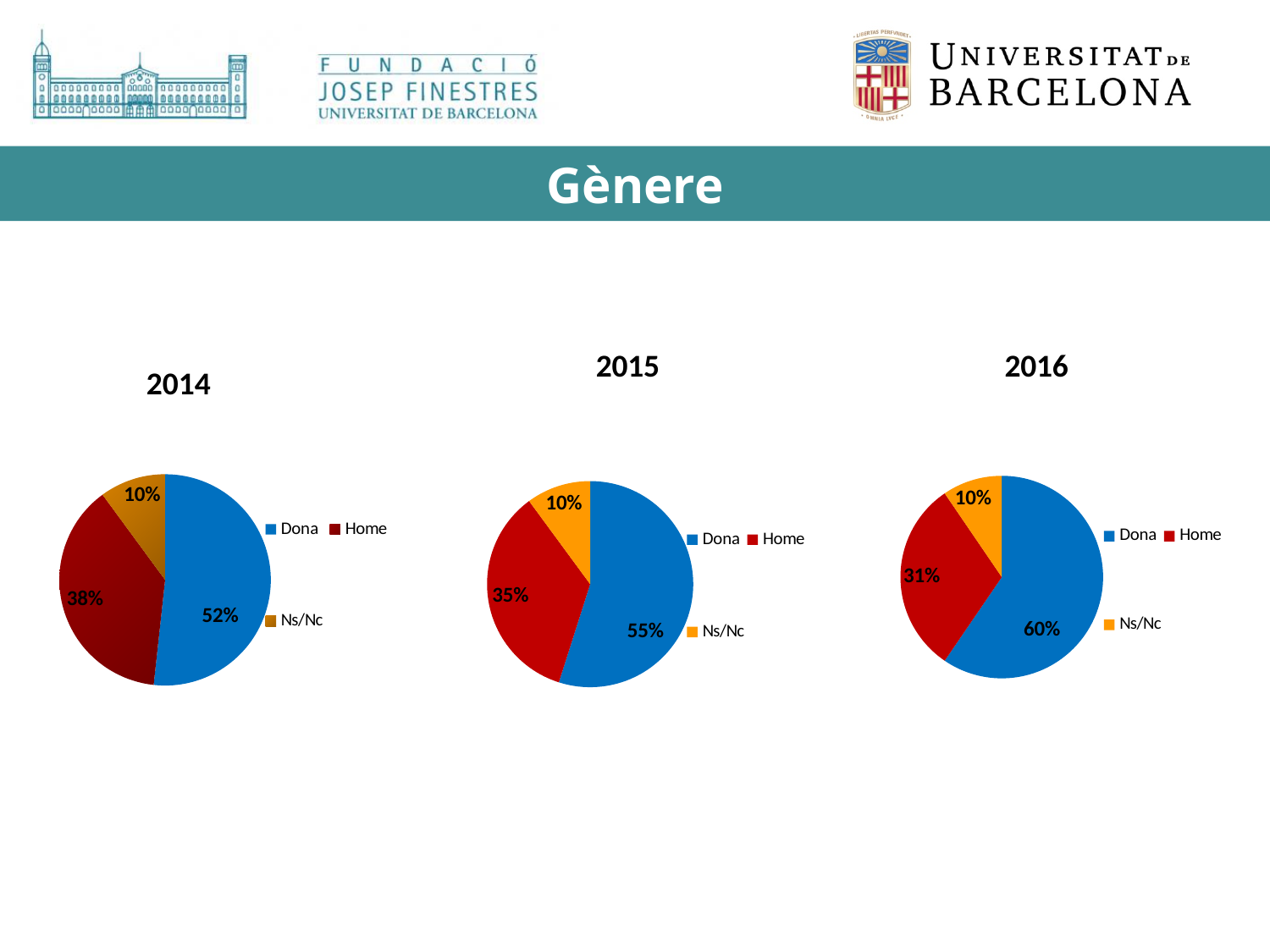
In the 2014 pie chart, what share is labelled for Dona? 52% What is the title shown in the banner above the three charts? Gènere In the 2016 pie chart, what share is labelled for Dona? 60% How many categories does the legend of the 2016 pie chart list? 3 In the 2015 pie chart, which category has the largest slice? Dona In the 2016 pie chart, what share is labelled for Home? 31% What kind of chart is used for the 2014 data? Pie chart In the 2016 pie chart, what is the difference between the Dona and Home shares? 29% In the 2014 pie chart, which category has the smallest slice? Ns/Nc In the 2015 pie chart, what share is labelled for Home? 35% In the 2014 pie chart, what share is labelled for Home? 38% In the 2015 pie chart, which is larger, the Dona slice or the Home slice? Dona